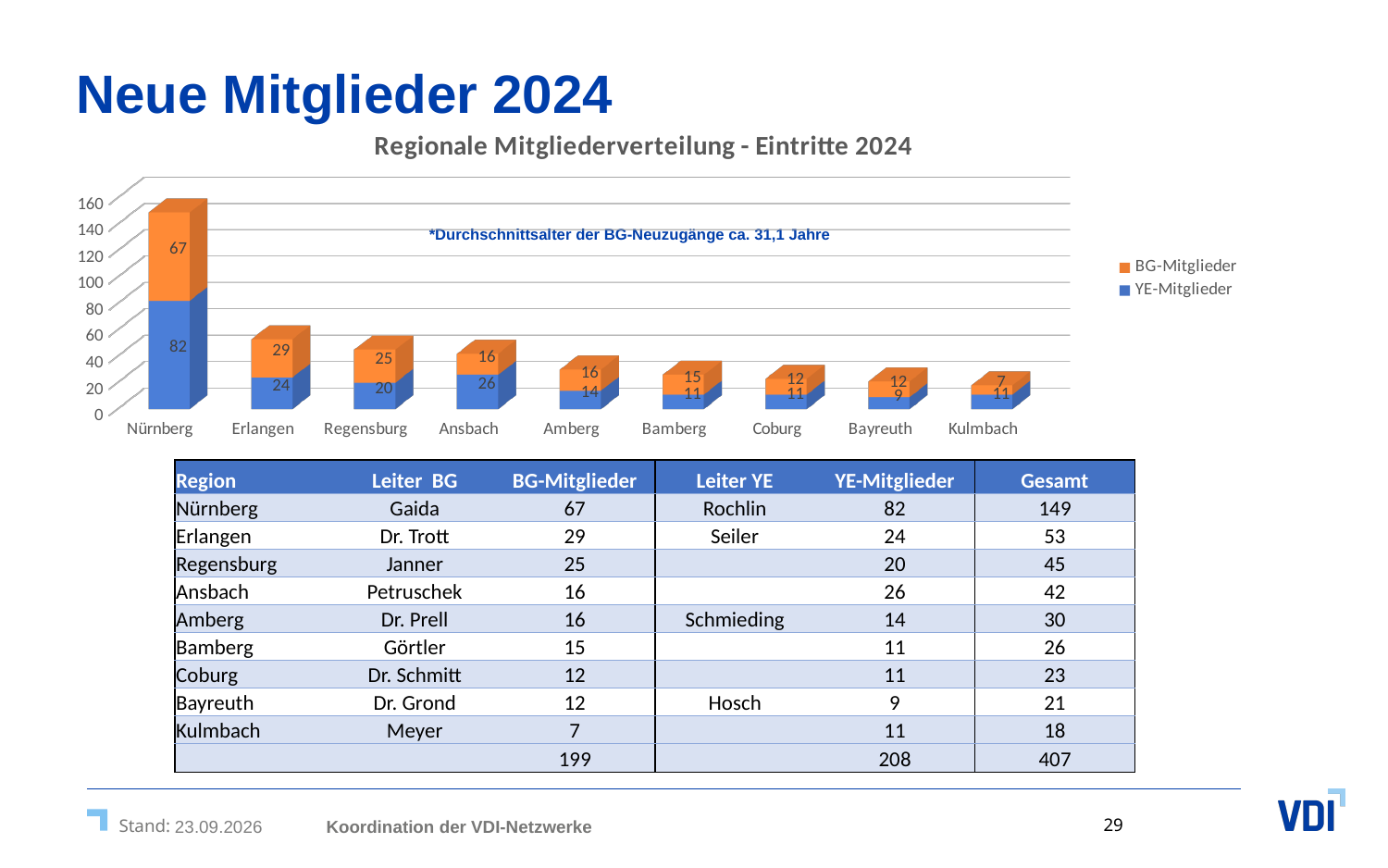
Which is larger for Ansbach: BG-Mitglieder or YE-Mitglieder? YE-Mitglieder What is the BG-Mitglieder value for Nürnberg? 67 Which region has the lowest BG-Mitglieder value? Kulmbach How many regions are shown on the x axis of the chart? 9 Which region has the highest YE-Mitglieder value? Nürnberg What is the total of the stacked bar for Erlangen? 53 What is the difference between the YE-Mitglieder values for Nürnberg and Erlangen? 58 Is the total stacked bar for Nürnberg greater or less than 140? greater What is the title of the chart? Regionale Mitgliederverteilung - Eintritte 2024 What kind of chart is shown on the slide? stacked bar chart What is the YE-Mitglieder value for Ansbach? 26 How many series does the chart legend list? 2